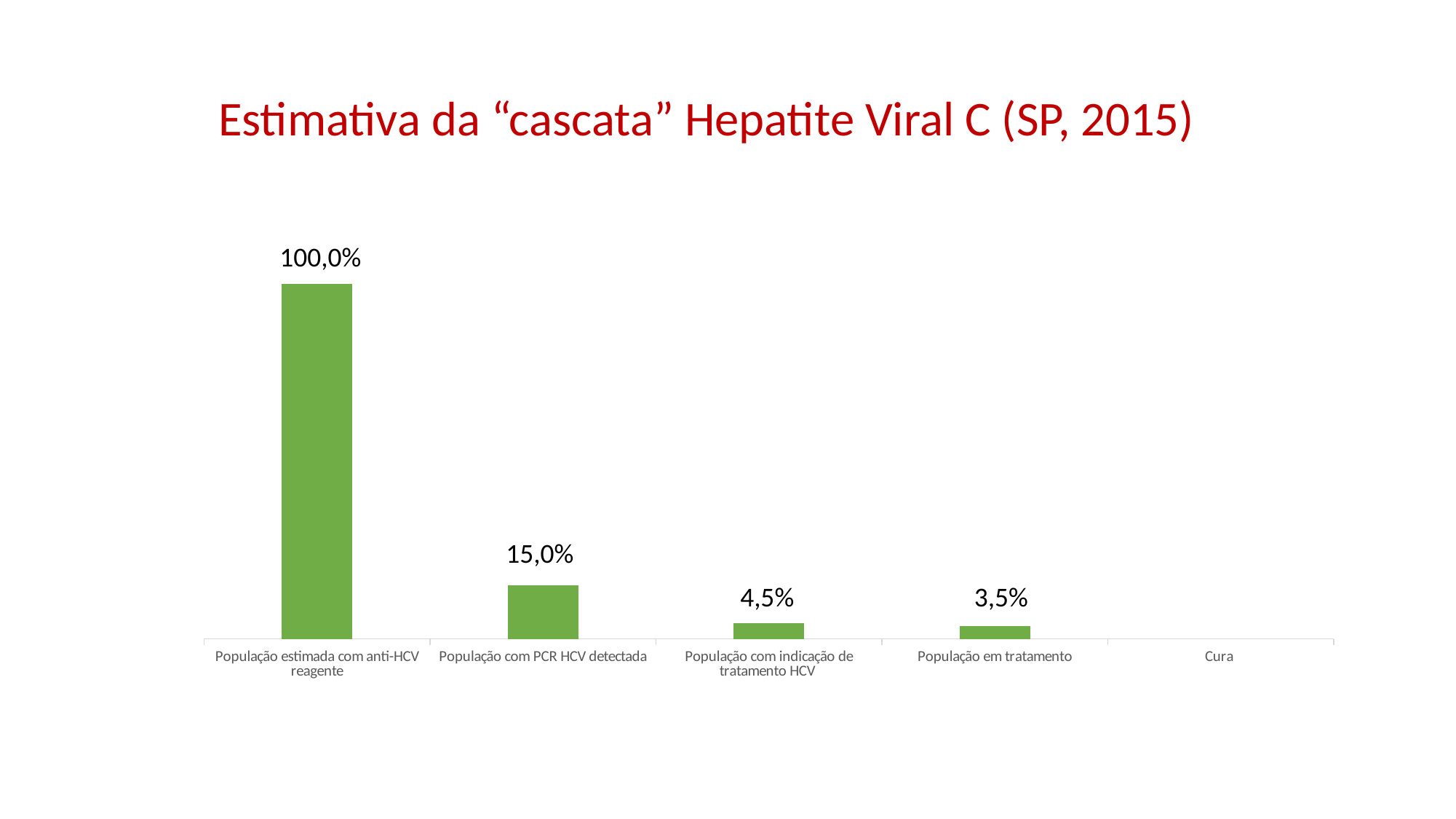
Which is larger, the value for População com PCR HCV detectada or the value for População em tratamento? População com PCR HCV detectada Which category has the highest value? População estimada com anti-HCV reagente How many categories are shown on the x axis? 5 What is the difference between the values for População com indicação de tratamento HCV and População em tratamento? 1,0% What is the value for População em tratamento? 3,5% Which category with a plotted bar has the lowest value? População em tratamento What is the value for População com indicação de tratamento HCV? 4,5% What is the difference between the values for População com PCR HCV detectada and População com indicação de tratamento HCV? 10,5% What is the value for População com PCR HCV detectada? 15,0% What is the value for População estimada com anti-HCV reagente? 100,0% What is the title of the chart? Estimativa da “cascata” Hepatite Viral C (SP, 2015) What kind of chart is shown on the slide? Bar chart